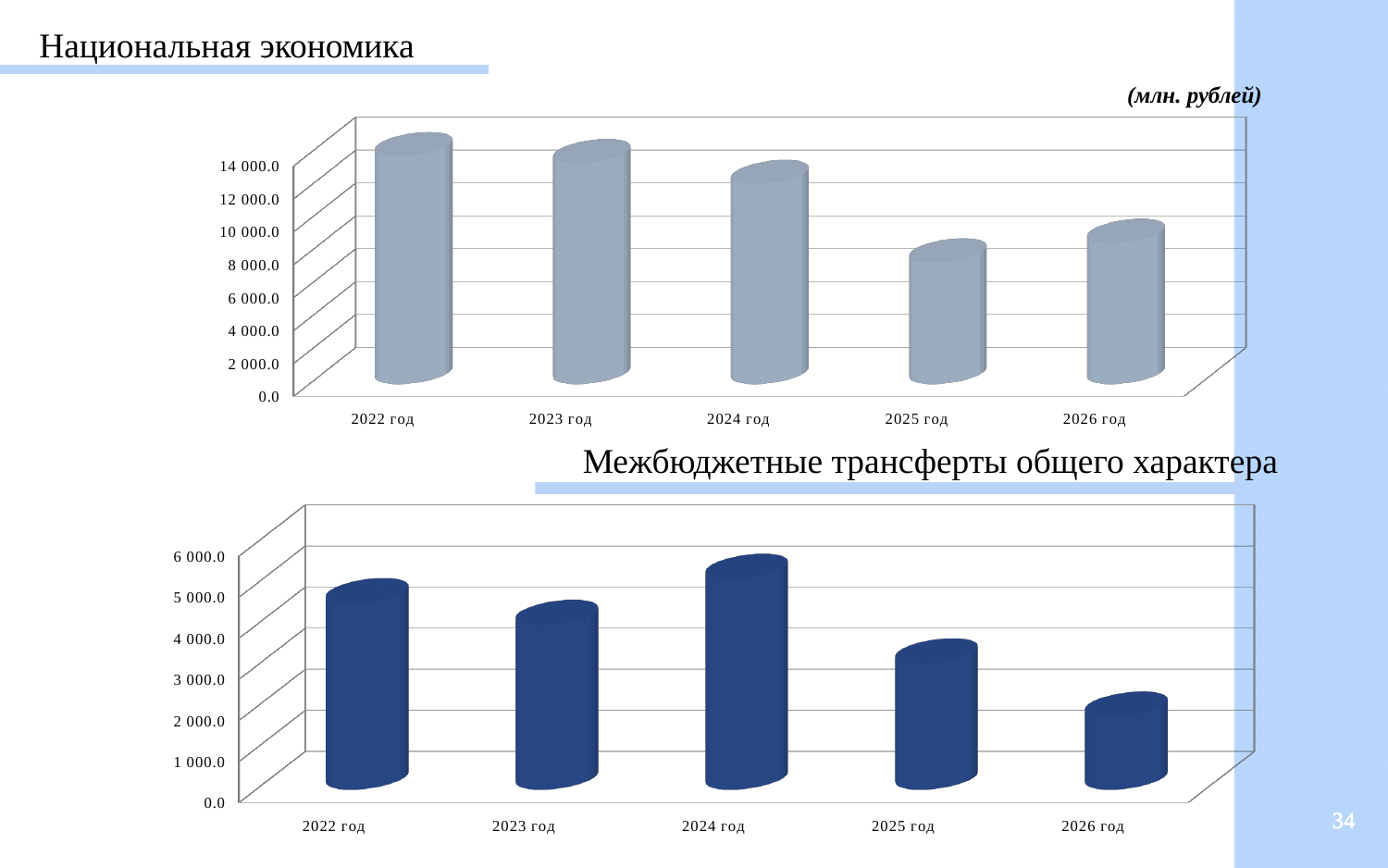
In the bottom chart (Межбюджетные трансферты общего характера), which year has the lowest value? 2026 год In the top chart (Национальная экономика), which year has the lowest value? 2025 год In the bottom chart (Межбюджетные трансферты общего характера), is the value for 2026 год greater or less than 3 000.0? less In the top chart (Национальная экономика), is the value for 2025 год greater or less than 10 000.0? less How many years are shown on the x axis of the top chart (Национальная экономика)? 5 In the bottom chart (Межбюджетные трансферты общего характера), which is larger, the value for 2022 год or 2023 год? 2022 год In the top chart (Национальная экономика), is the value for 2022 год greater or less than 12 000.0? greater What kind of chart is the top chart (Национальная экономика)? bar chart In the top chart (Национальная экономика), do the values rise or fall from 2022 год to 2025 год? fall In the bottom chart (Межбюджетные трансферты общего характера), which year has the highest value? 2024 год In the top chart (Национальная экономика), which year has the highest value? 2022 год In the top chart (Национальная экономика), which is larger, the value for 2025 год or 2026 год? 2026 год